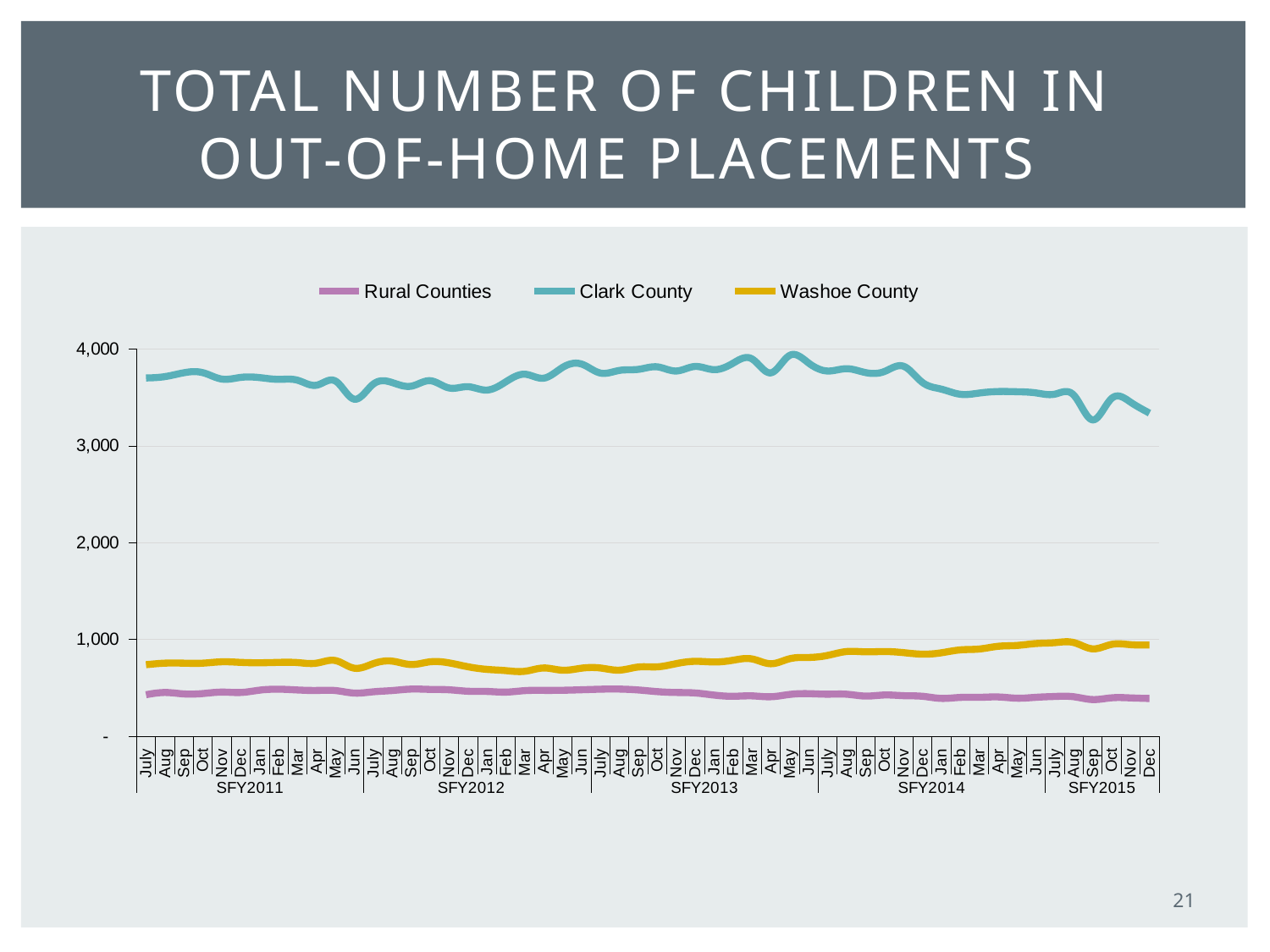
Is the value for Clark County in July SFY2011 greater or less than 3,000? greater What kind of chart is shown on the slide? Line chart Is the value for Washoe County in July SFY2011 greater or less than 1,000? less Which series is plotted with the lowest values throughout the chart? Rural Counties Is the value for Rural Counties in Dec SFY2015 greater or less than 1,000? less How many series does the legend list? 3 Does the Washoe County line generally rise or fall from July SFY2011 to Dec SFY2015? rise Which series is plotted with the highest values throughout the chart? Clark County How many state fiscal years are labeled on the x axis? 5 What is the title of the chart on the slide? Total Number of Children in Out-of-Home Placements Does the Clark County line rise or fall from Nov SFY2014 to Dec SFY2015? fall Which is larger in Dec SFY2015, the value for Washoe County or the value for Rural Counties? Washoe County